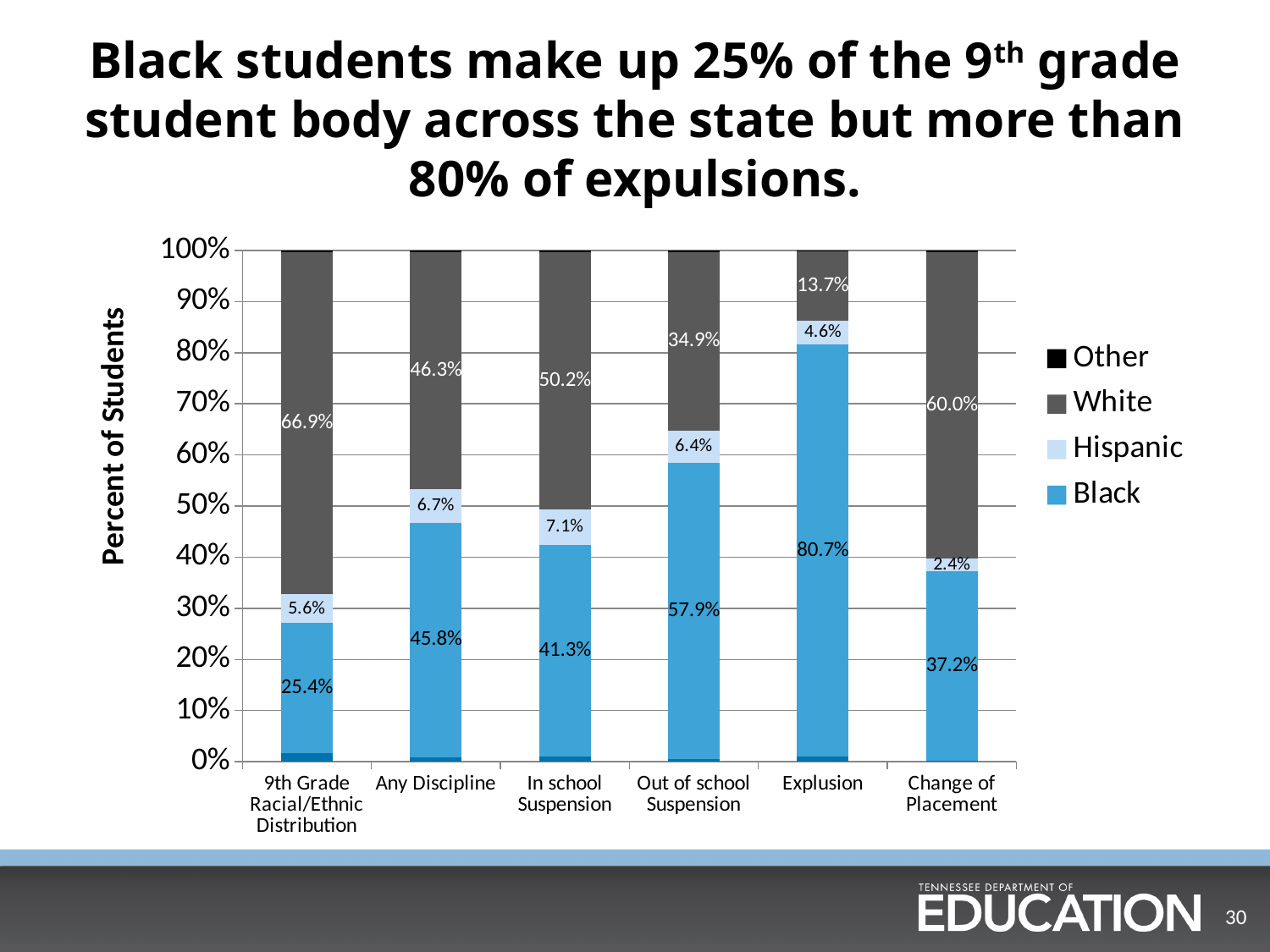
What is the difference between the Black share for Expulsion and the Black share for 9th Grade Racial/Ethnic Distribution? 55.3% How many series does the legend list? 4 What is the White share for the 9th Grade Racial/Ethnic Distribution category? 66.9% How many categories are shown on the x axis? 6 Which category has the highest Black share? Expulsion What is the label of the vertical axis? Percent of Students What kind of chart is shown on the slide? Stacked bar chart What is the Hispanic share for In school Suspension? 7.1% What is the White share for Change of Placement? 60.0% Which category has the lowest Hispanic share? Change of Placement Which is larger, the White share for Any Discipline or the White share for In school Suspension? In school Suspension What is the Black share for the Expulsion category? 80.7%